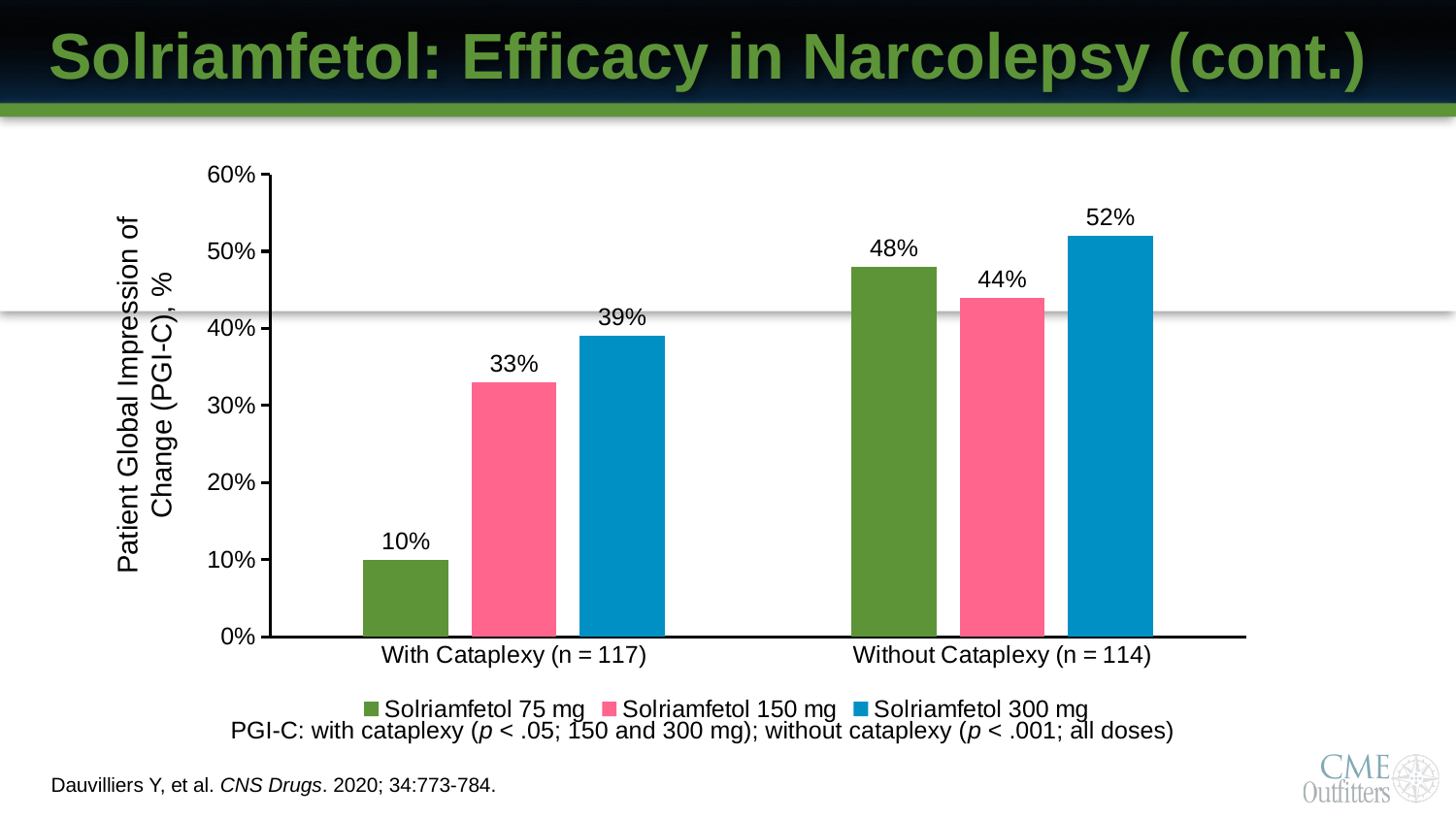
What is the value for Solriamfetol 150 mg in the With Cataplexy (n = 117) group? 33% How many patient groups are shown on the x axis? 2 Is the value for Solriamfetol 150 mg in the Without Cataplexy (n = 114) group greater or less than 40%? greater How many series does the legend list? 3 Which is larger in the Without Cataplexy (n = 114) group: Solriamfetol 75 mg or Solriamfetol 150 mg? Solriamfetol 75 mg What is the difference between the Solriamfetol 300 mg values for the Without Cataplexy and With Cataplexy groups? 13% What kind of chart is shown on the slide? Bar chart What is the y-axis label of the chart? Patient Global Impression of Change (PGI-C), % Which dose has the highest value in the Without Cataplexy (n = 114) group? Solriamfetol 300 mg What is the value for Solriamfetol 75 mg in the With Cataplexy (n = 117) group? 10% Which dose has the lowest value in the With Cataplexy (n = 117) group? Solriamfetol 75 mg What is the value for Solriamfetol 300 mg in the Without Cataplexy (n = 114) group? 52%